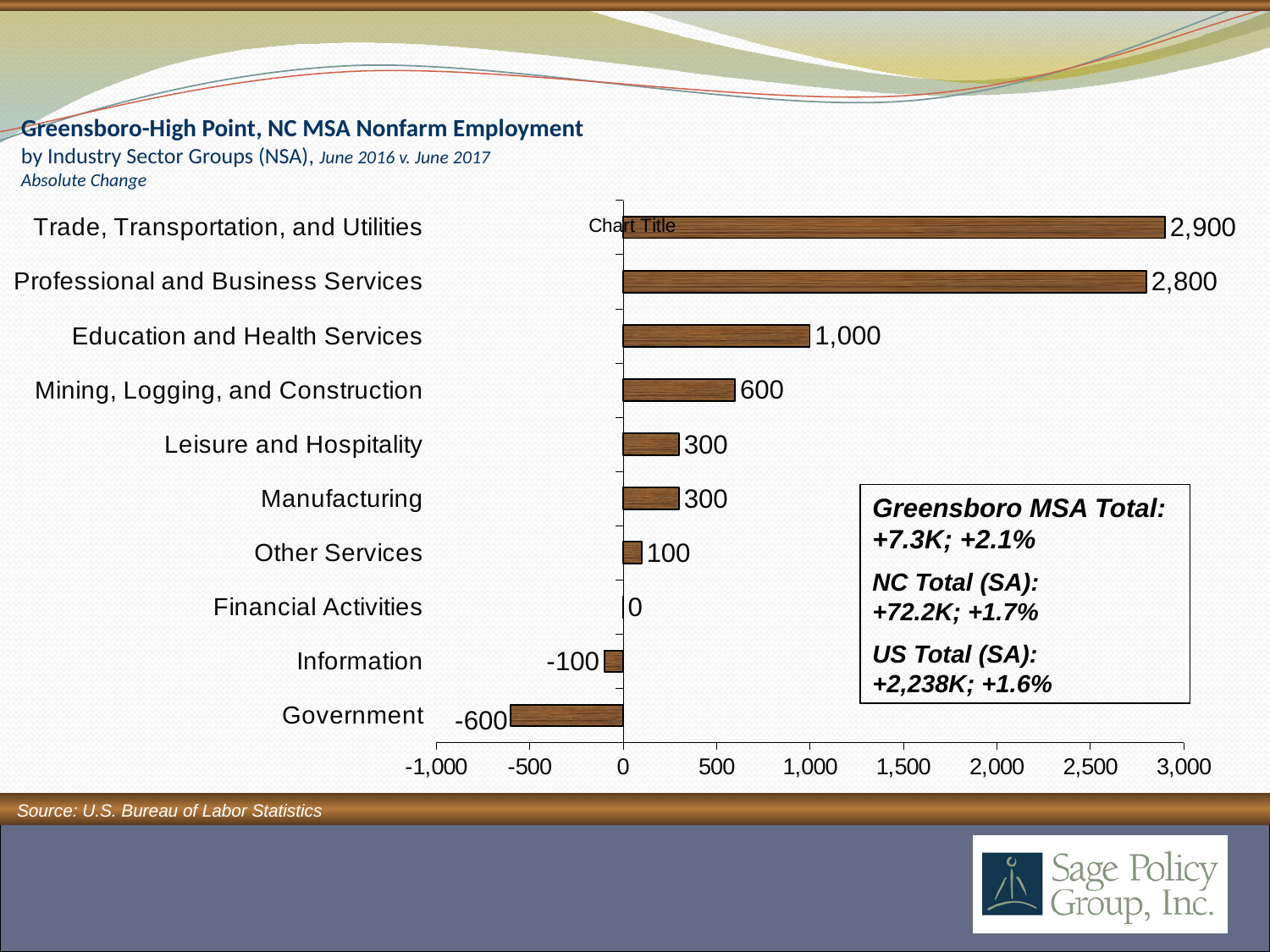
Which industry sector has the lowest value? Government What kind of chart is shown on the slide? bar chart What is the value for Financial Activities? 0 What is the value for Government? -600 What is the value for Information? -100 Which industry sector has the highest value? Trade, Transportation, and Utilities What is the value for Trade, Transportation, and Utilities? 2,900 Is the value for Professional and Business Services greater or less than 2,500? greater How many industry sector categories are shown in the chart? 10 What is the value for Education and Health Services? 1,000 Which is larger, the value for Mining, Logging, and Construction or the value for Leisure and Hospitality? Mining, Logging, and Construction What is the difference between the values for Professional and Business Services and Education and Health Services? 1,800